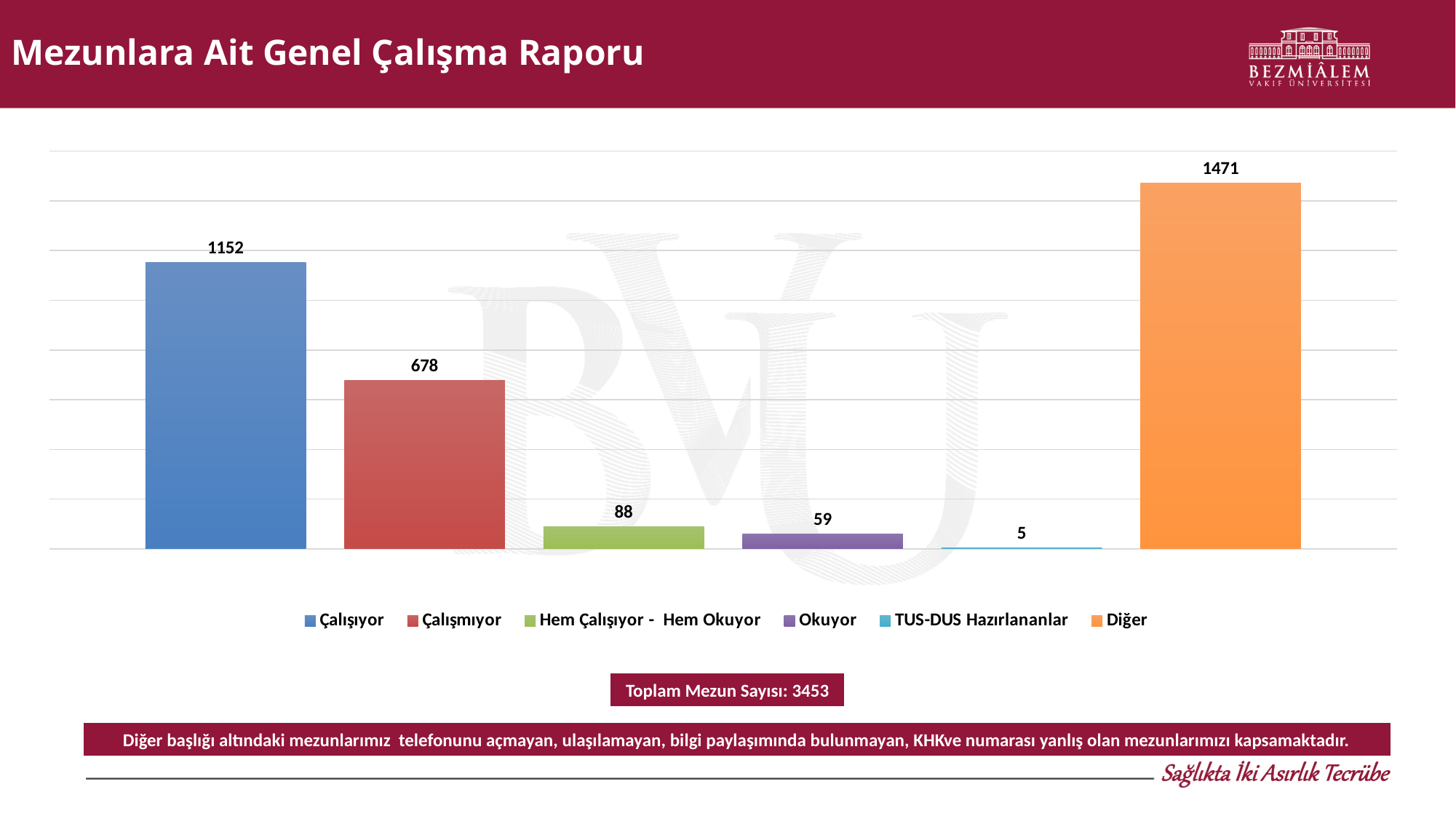
What is the value for Hem Çalışıyor - Hem Okuyor? 88 Which is larger, the value for Okuyor or the value for Hem Çalışıyor - Hem Okuyor? Hem Çalışıyor - Hem Okuyor What is the value for Diğer? 1471 What colour is the bar for Çalışmıyor? Red What is the difference between the values for Diğer and Çalışıyor? 319 How many categories are shown in the chart? 6 What is the difference between the values for Çalışıyor and Çalışmıyor? 474 Which category has the highest value? Diğer What kind of chart is shown on the slide? Bar chart What is the value for TUS-DUS Hazırlananlar? 5 Which category has the lowest value? TUS-DUS Hazırlananlar What is the value for Çalışıyor? 1152